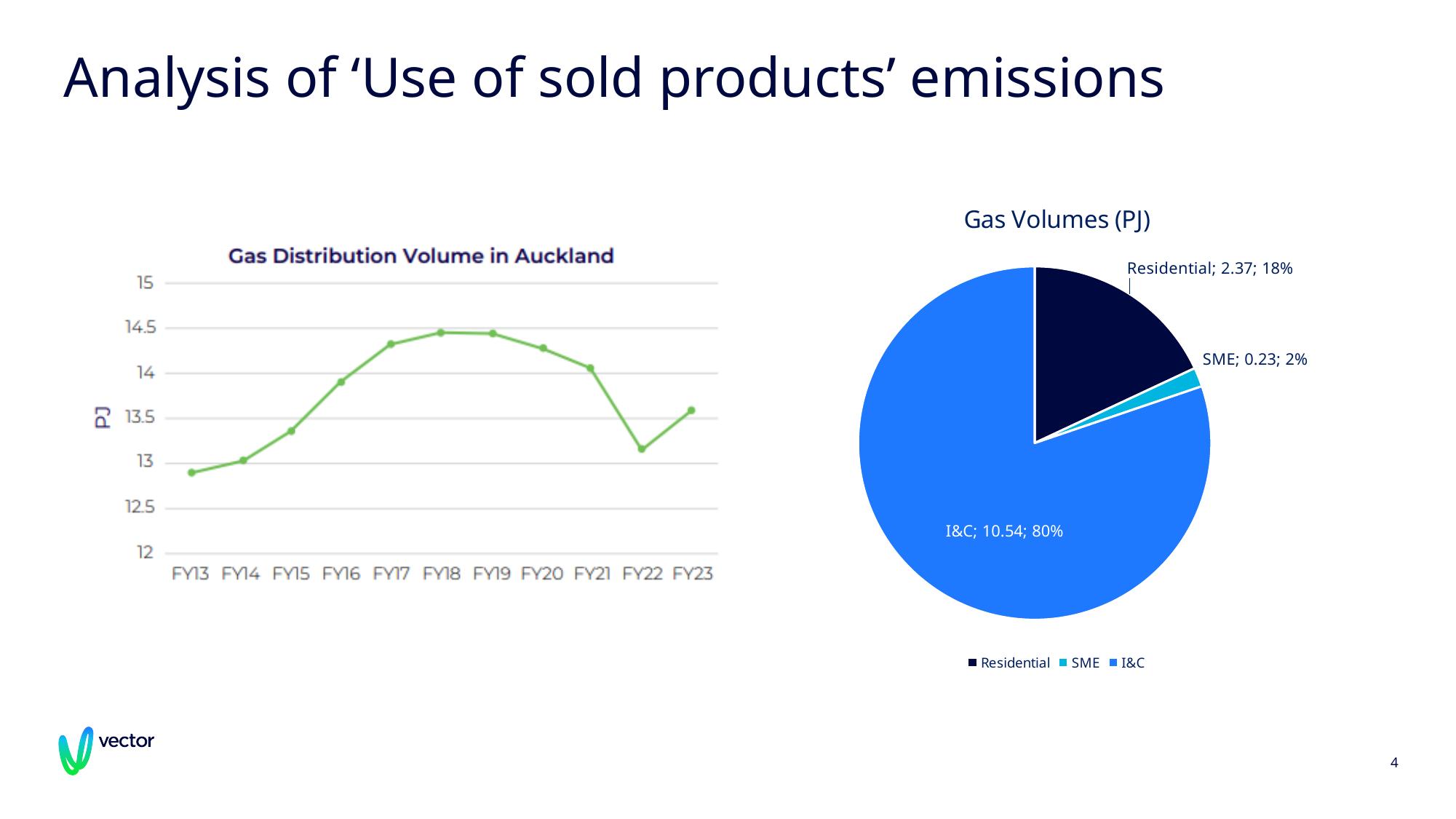
In the 'Gas Distribution Volume in Auckland' chart, do the values rise or fall from FY13 to FY18? rise In the 'Gas Volumes (PJ)' pie chart, which category has the smallest slice? SME In the 'Gas Distribution Volume in Auckland' chart, is the value for FY18 greater or less than 14? greater How many categories does the legend of the 'Gas Volumes (PJ)' pie chart list? 3 How many fiscal years are plotted on the x axis of the 'Gas Distribution Volume in Auckland' chart? 11 In the 'Gas Distribution Volume in Auckland' chart, is the value for FY13 greater or less than 13? less In the 'Gas Volumes (PJ)' pie chart, which category has the largest slice? I&C In the 'Gas Volumes (PJ)' pie chart, what is the value for I&C? 10.54 In the 'Gas Volumes (PJ)' pie chart, what is the difference between the I&C value and the Residential value? 8.17 In the 'Gas Volumes (PJ)' pie chart, what share of the pie does Residential represent? 18% In the 'Gas Volumes (PJ)' pie chart, what is the value for SME? 0.23 What kind of chart is 'Gas Distribution Volume in Auckland'? Line chart